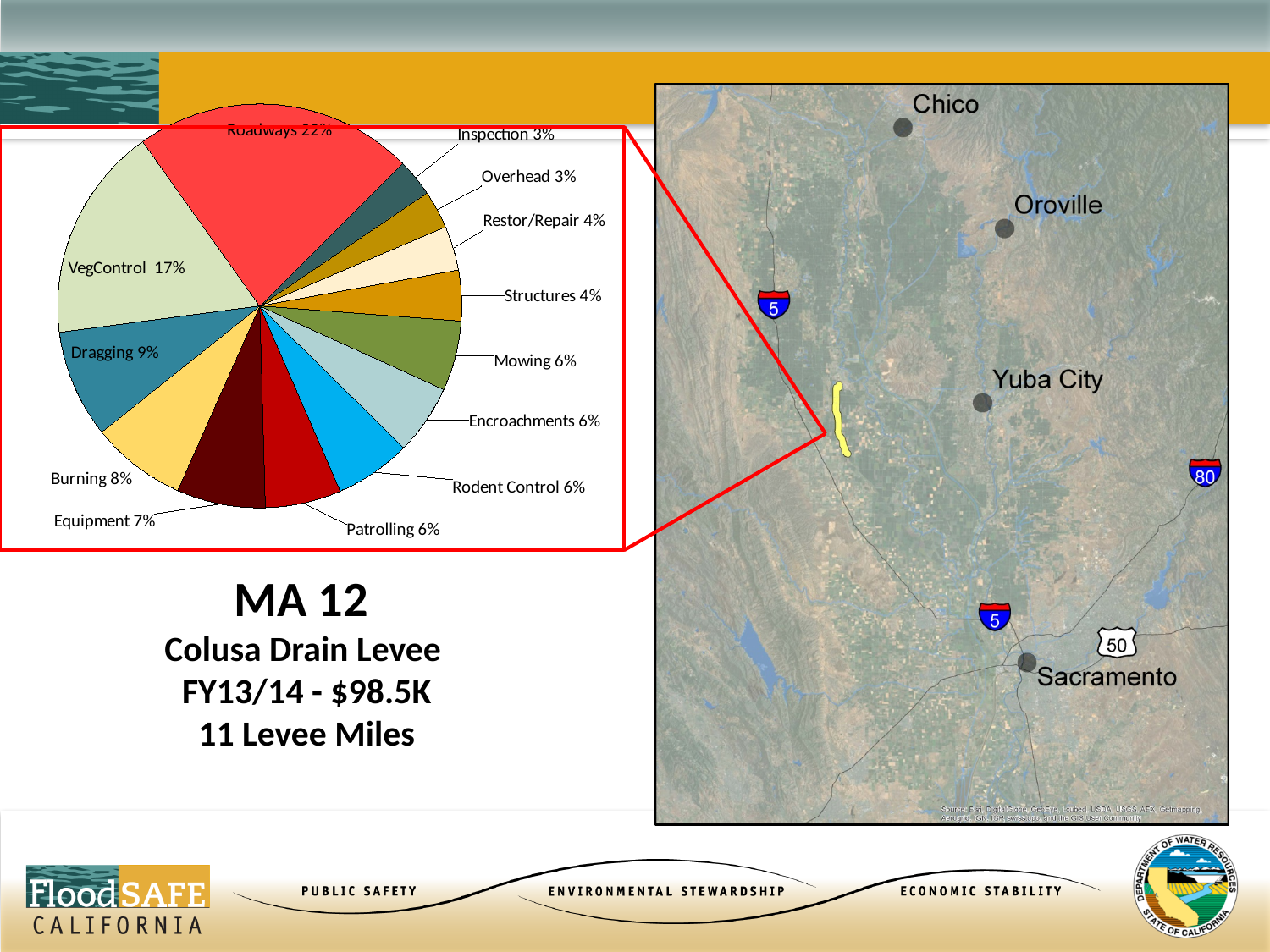
By how many percentage points does VegControl exceed Dragging? 8 percentage points How many slices does the pie chart have? 13 What percentage does the Dragging slice represent? 9% What percentage is shown for Rodent Control? 6% Which category has the largest slice of the pie chart? Roadways Which is larger in the pie chart, VegControl or Dragging? VegControl What is the value for Restor/Repair in the pie chart? 4% What percentage of the pie chart is VegControl? 17% What kind of chart is shown on the left of the slide? pie chart Which is larger in the pie chart, Burning or Equipment? Burning What percentage is labelled for Equipment? 7% What is the value shown for Burning in the pie chart? 8%